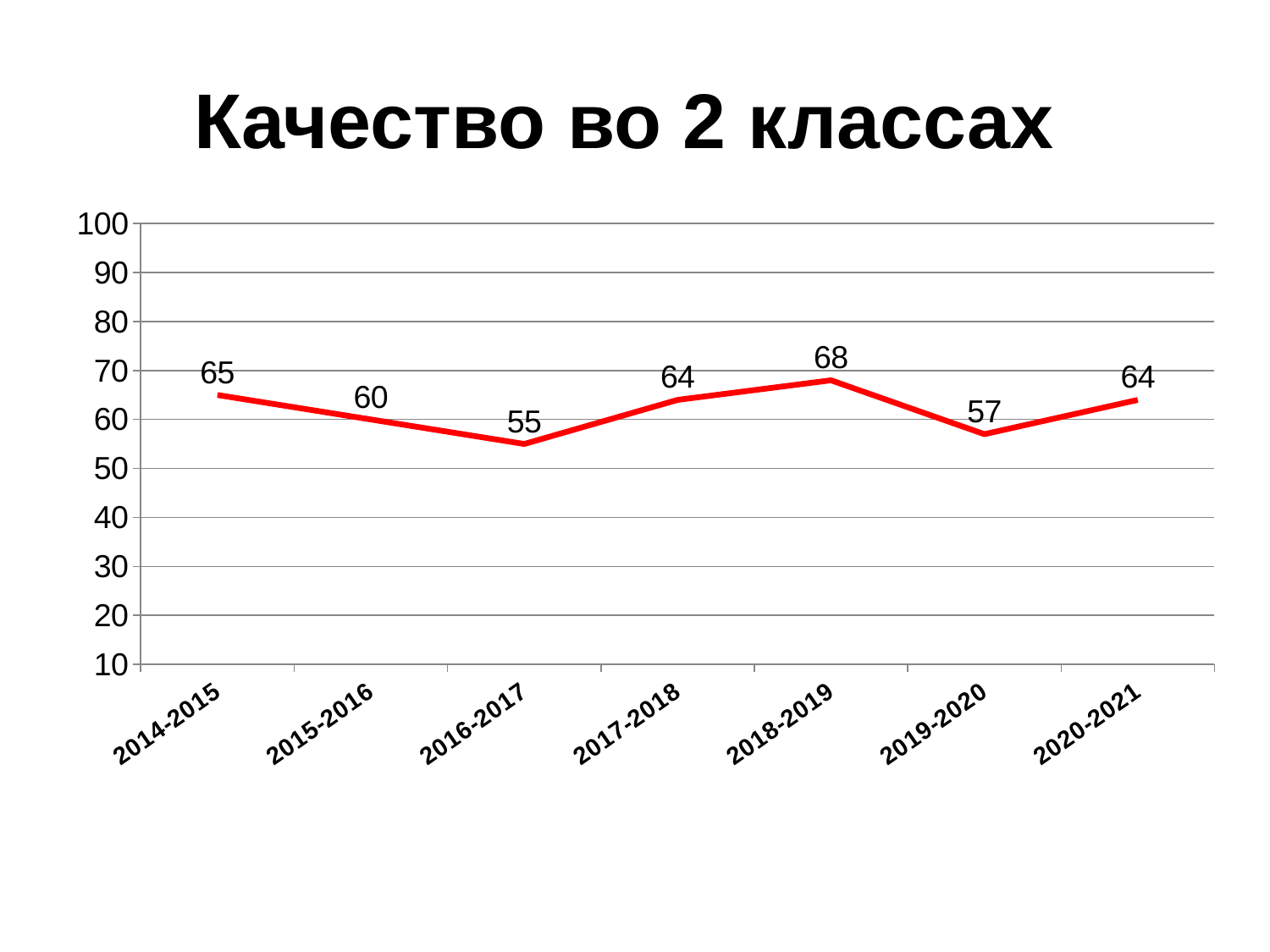
What kind of chart is shown on the slide? line chart Is the value for 2018-2019 greater or less than 60? greater What is the value for 2014-2015? 65 Which year has the highest value? 2018-2019 What is the value for 2019-2020? 57 Does the value rise or fall from 2019-2020 to 2020-2021? rise What is the difference between the values for 2018-2019 and 2016-2017? 13 How many years are plotted on the chart? 7 Which year has the lowest value? 2016-2017 What is the title of the chart? Качество во 2 классах What is the value for 2016-2017? 55 Which is larger, the value for 2015-2016 or the value for 2017-2018? 2017-2018